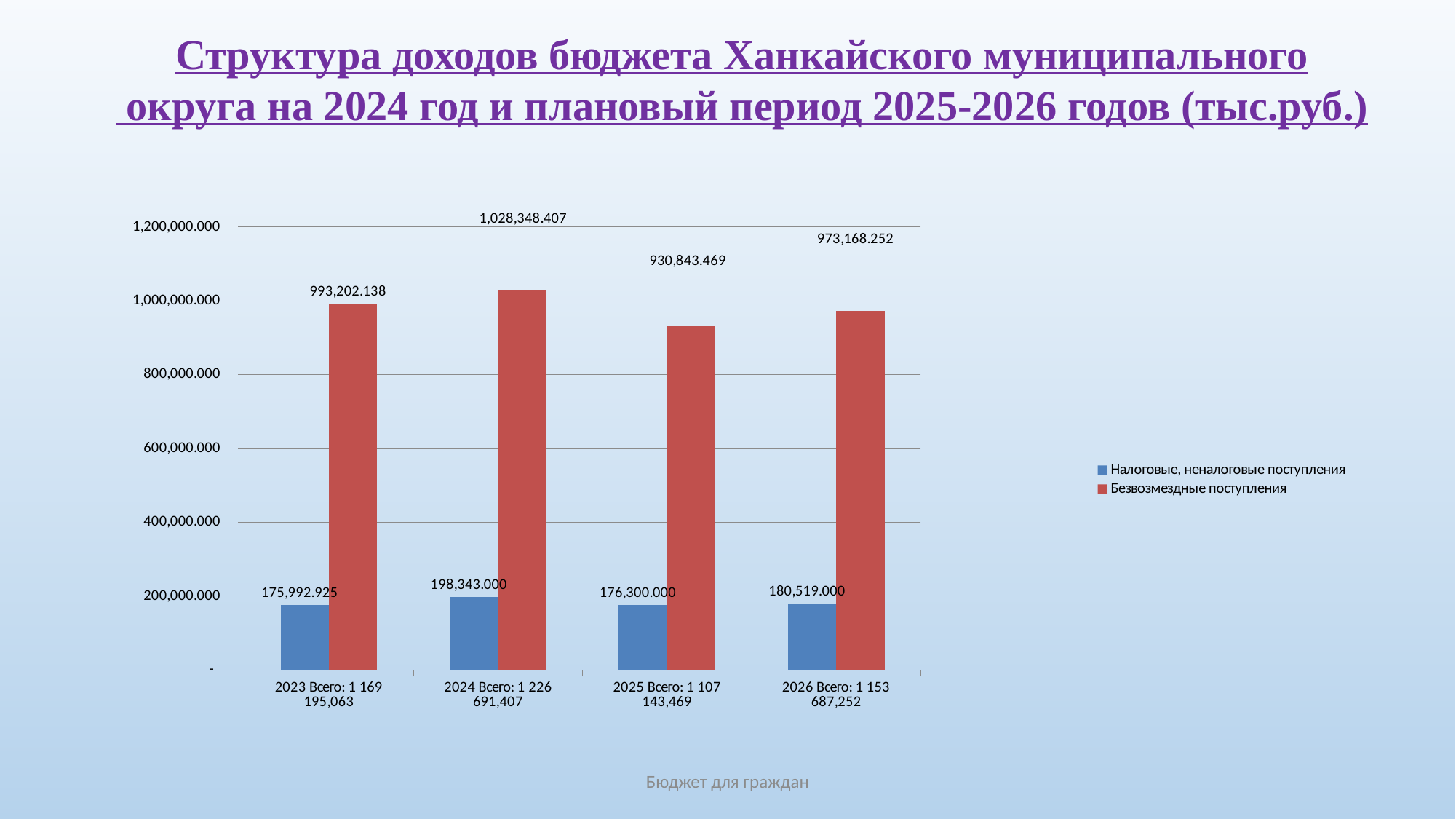
What kind of chart is shown on the slide? bar chart In which year is Безвозмездные поступления lowest? 2025 What is the value of Налоговые, неналоговые поступления for 2023? 175,992.925 What is the value of Безвозмездные поступления for 2026? 973,168.252 Which is larger: Налоговые, неналоговые поступления in 2025 or in 2026? 2026 How many years (categories) are shown on the x axis? 4 What is the difference between Безвозмездные поступления in 2024 and in 2023? 35,146.269 How many series does the legend list? 2 What is the value of Безвозмездные поступления for 2024? 1,028,348.407 Is the value of Безвозмездные поступления for 2025 greater or less than 1,000,000.000? less In which year is Налоговые, неналоговые поступления highest? 2024 In which year is Безвозмездные поступления highest? 2024